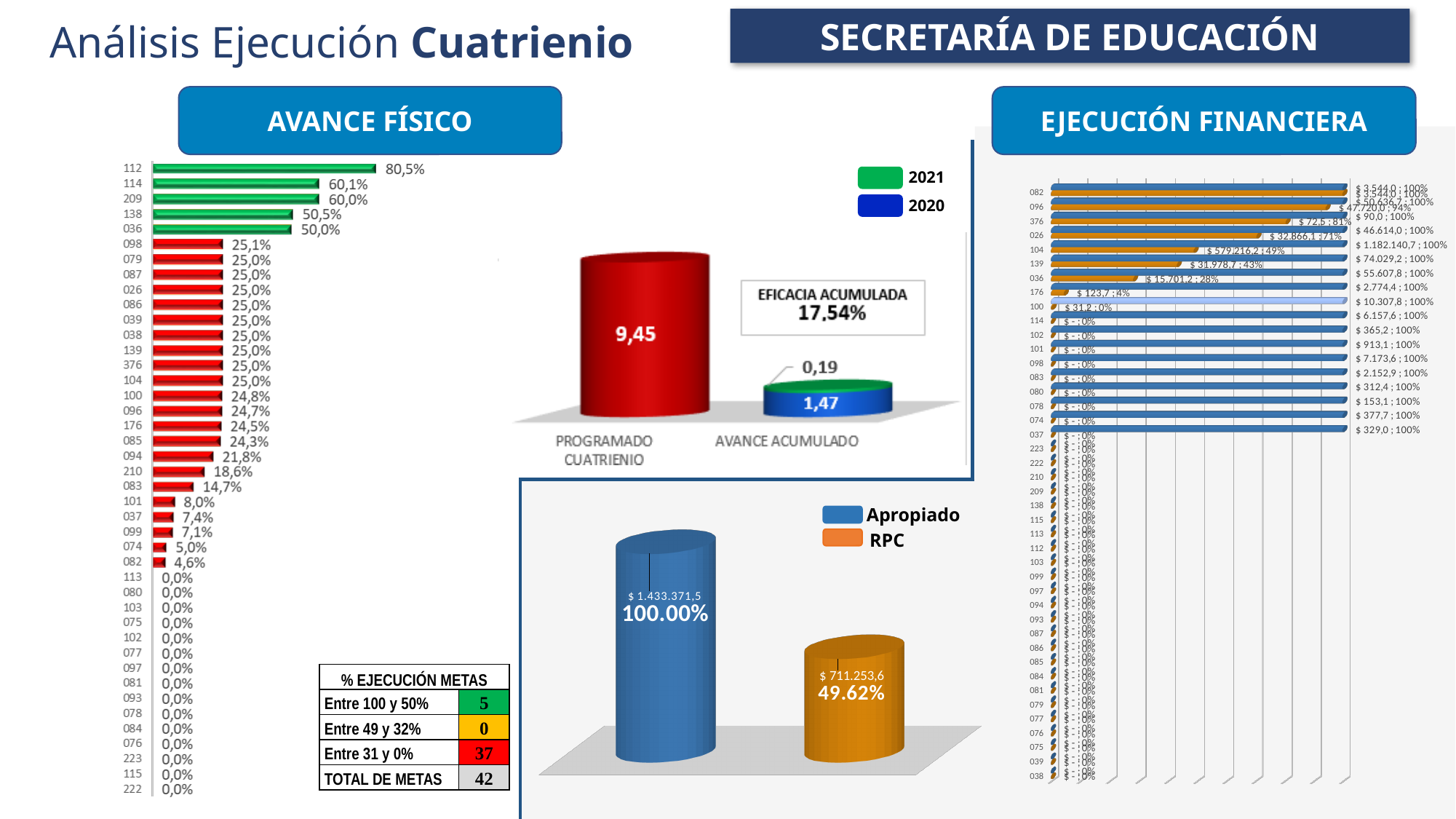
In the AVANCE FÍSICO bar chart, what is the difference between the values for 114 and 209? 0,1 percentage points What kind of chart is the AVANCE FÍSICO chart? Bar chart In the EJECUCIÓN FINANCIERA bar chart, what is the Apropiado value for category 104? $ 1.182.140,7 In the Apropiado / RPC chart at the bottom of the slide, what percentage is shown for RPC? 49.62% In the PROGRAMADO CUATRIENIO / AVANCE ACUMULADO chart, what is the 2021 value for AVANCE ACUMULADO? 0,19 In the Apropiado / RPC chart at the bottom of the slide, which is larger, Apropiado or RPC? Apropiado In the AVANCE FÍSICO bar chart, which category has the highest value? 112 In the Apropiado / RPC chart at the bottom of the slide, what is the amount shown for RPC? $ 711.253,6 How many series does the legend of the PROGRAMADO CUATRIENIO / AVANCE ACUMULADO chart list? 2 In the PROGRAMADO CUATRIENIO / AVANCE ACUMULADO chart in the middle of the slide, what is the value for PROGRAMADO CUATRIENIO? 9,45 In the EJECUCIÓN FINANCIERA bar chart, what percentage is shown for the RPC bar of category 036? 28% In the AVANCE FÍSICO bar chart, what is the value for category 112? 80,5%